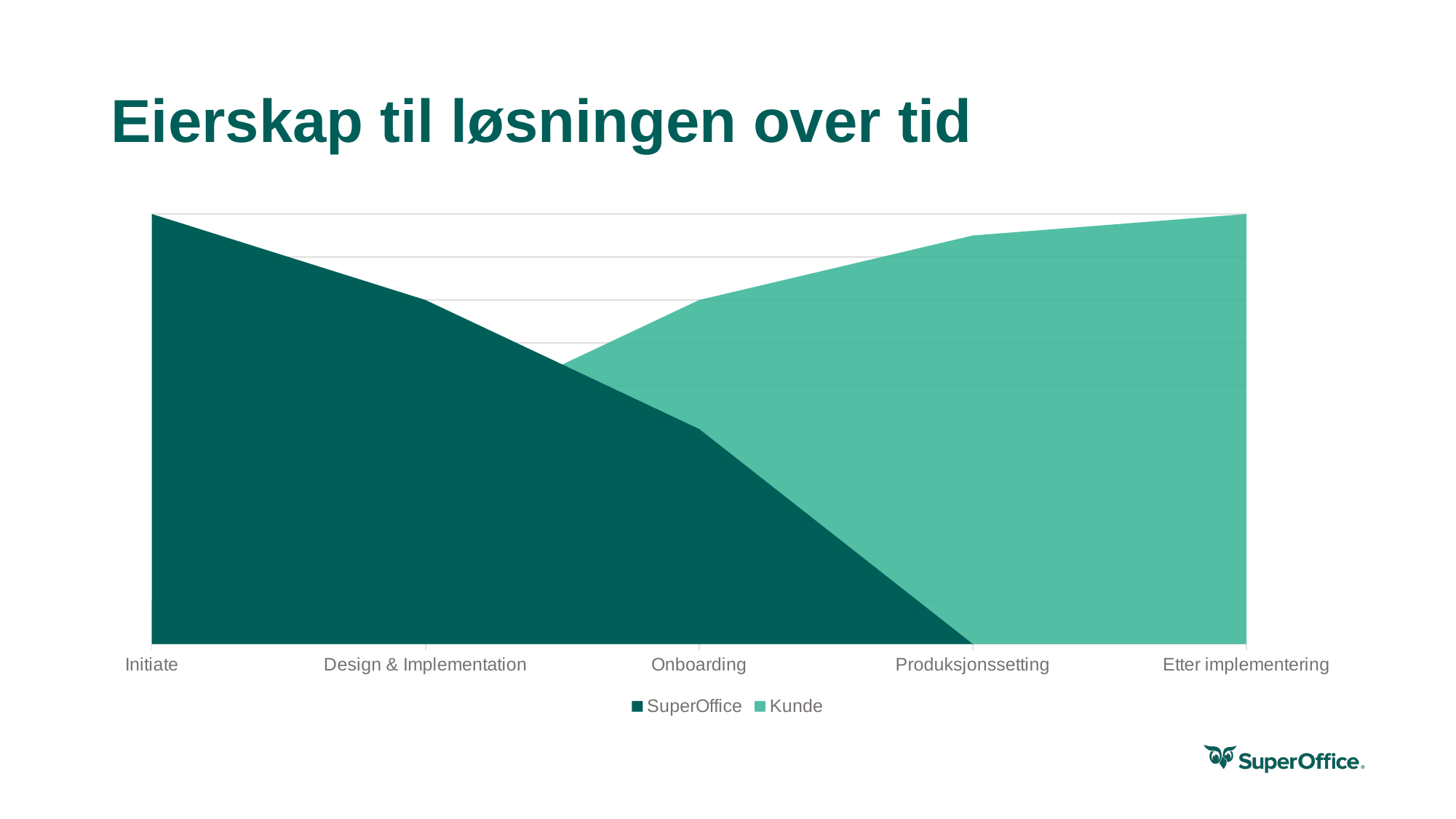
What kind of chart is shown on the slide? Area chart At Produksjonssetting, which series has the larger value, SuperOffice or Kunde? Kunde What is the title of the slide? Eierskap til løsningen over tid At which category is the SuperOffice series lowest? Produksjonssetting and Etter implementering (tied at the bottom) At Initiate, which series has the larger value, SuperOffice or Kunde? SuperOffice How many categories are shown along the x axis? 5 Does the SuperOffice series rise or fall from Initiate to Etter implementering? Fall At which category is the SuperOffice series highest? Initiate Does the Kunde series rise or fall from Initiate to Etter implementering? Rise Which series is drawn in the darker green colour? SuperOffice At which category is the Kunde series highest? Etter implementering How many series does the legend list? 2